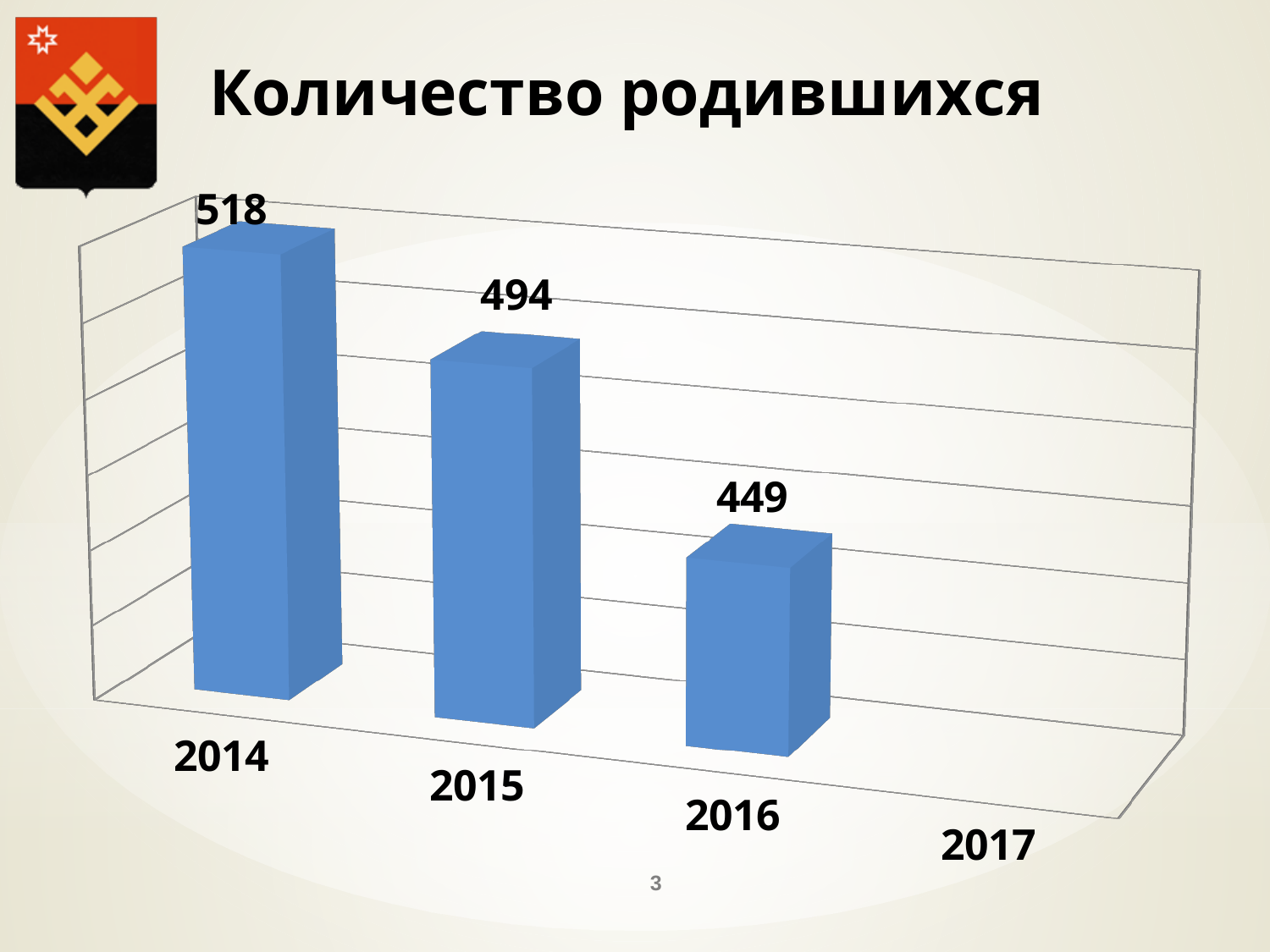
Do the values rise or fall from 2014 to 2016? fall What is the difference between the values for 2015 and 2016? 45 How many bars are plotted on the chart? 3 What is the difference between the values for 2014 and 2015? 24 What is the value for 2016? 449 What kind of chart is shown on the slide? bar chart Which year has the highest value? 2014 What is the value for 2015? 494 What is the value for 2014? 518 What is the difference between the values for 2014 and 2016? 69 Which year among those with a plotted bar has the lowest value? 2016 Which is larger, the value for 2015 or the value for 2016? 2015